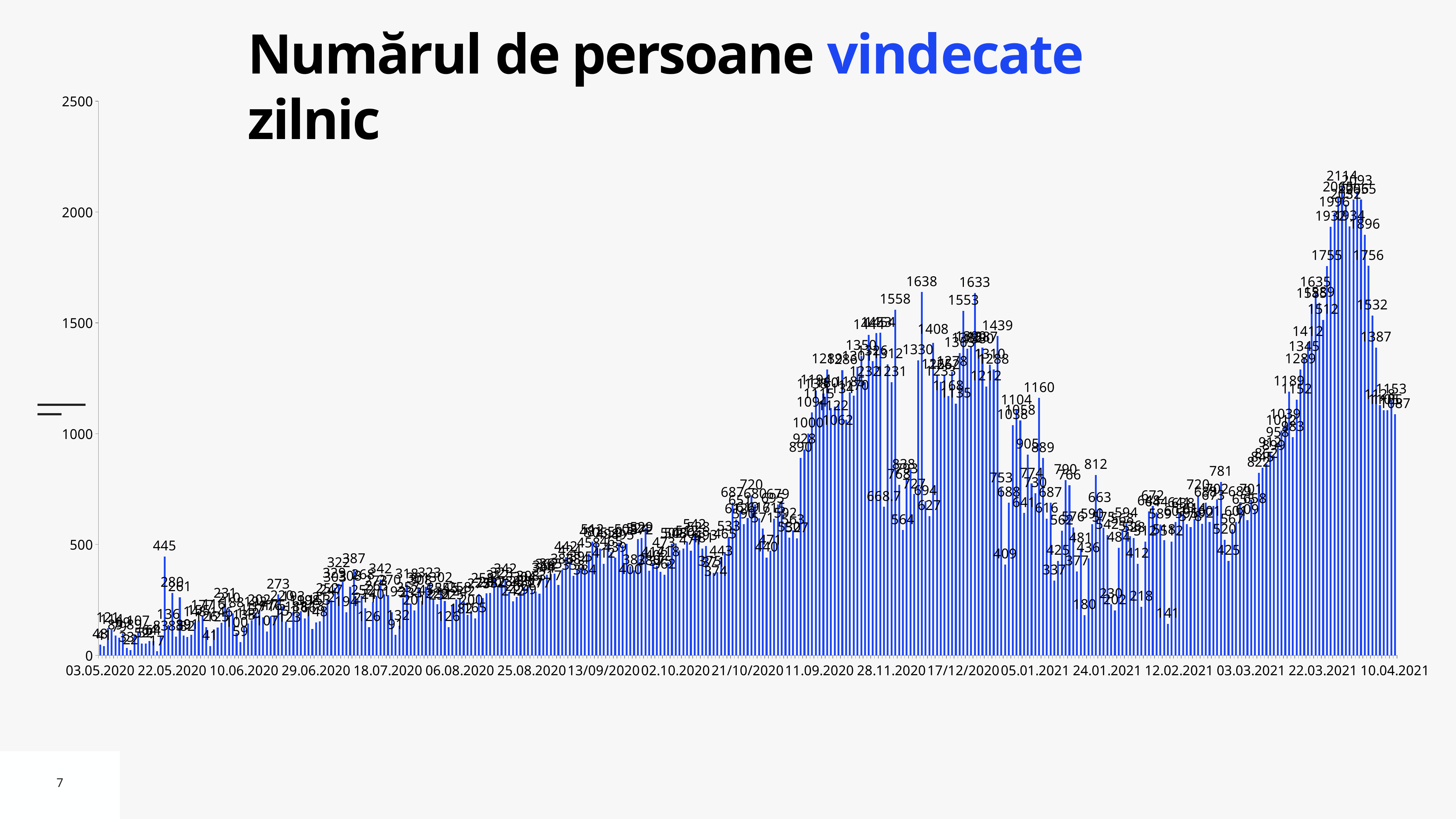
What is the first date shown on the x axis? 03.05.2020 What kind of chart is shown on the slide? bar chart Is the value for the last bar (10.04.2021) greater or less than 1000? greater What is the highest value labelled on the chart? 2114 Which is larger, the peak labelled 1638 or the peak labelled 1633? 1638 What is the difference between the highest labelled value (2114) and the peak labelled 1638? 476 Is the value for the first bar (03.05.2020) greater or less than 500? less What is the maximum value shown on the y axis? 2500 What is the title of the chart? Numărul de persoane vindecate zilnic What is the last date shown on the x axis? 10.04.2021 Overall, do the values rise or fall from May 2020 to April 2021? rise How many tick labels are shown on the y axis? 6